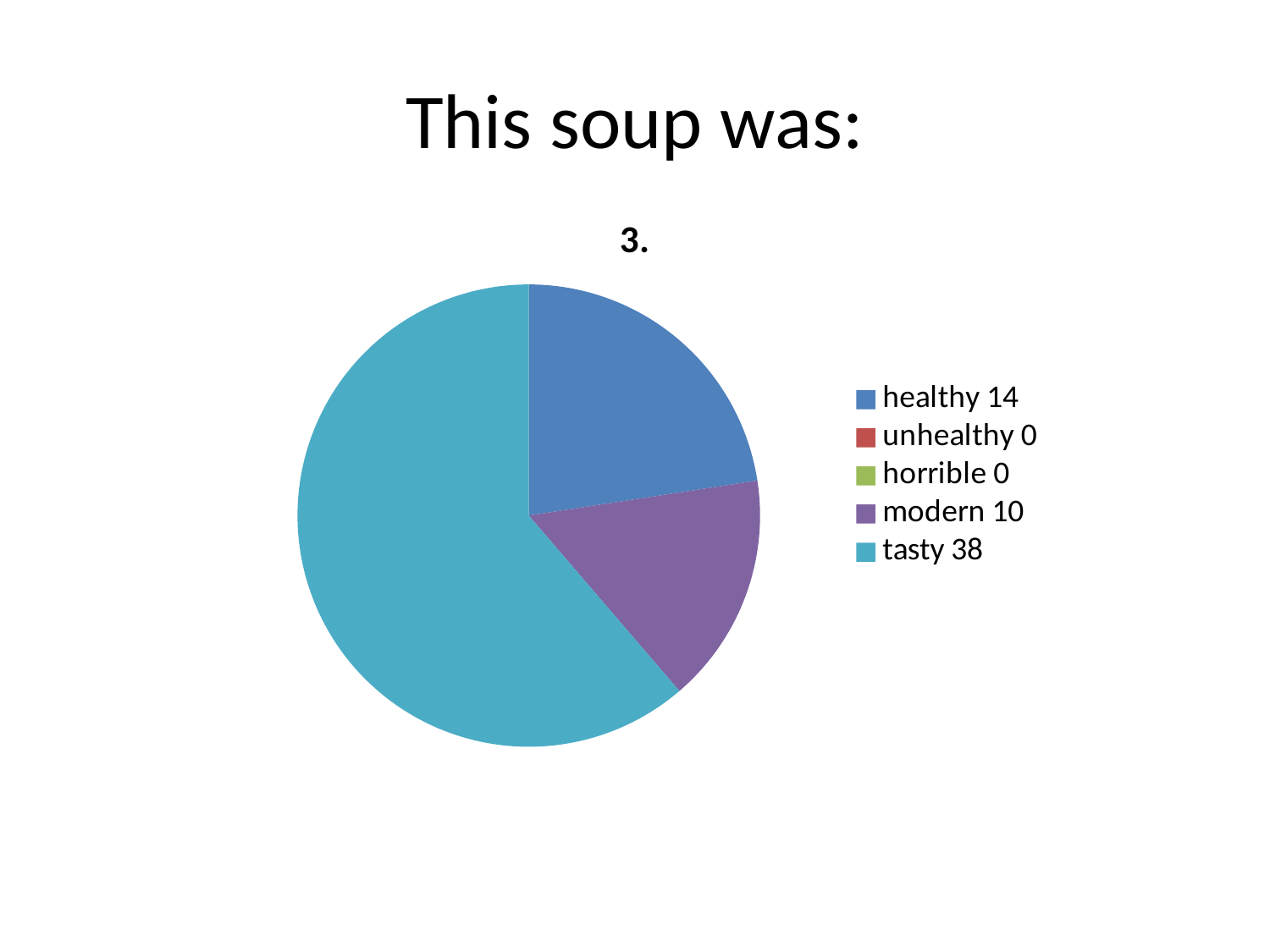
What is the total of all the values shown in the pie chart's legend? 62 What is the value for unhealthy in the pie chart? 0 How many categories does the legend of the pie chart list? 5 What is the value for healthy in the pie chart? 14 Which category has the largest slice of the pie chart? tasty What is the value for modern in the pie chart? 10 What type of chart is shown on the slide? pie chart What is the difference between the values for tasty and healthy? 24 What is the value for tasty in the pie chart? 38 What is the title shown above the pie chart? 3. Which is larger, the value for healthy or the value for modern? healthy Which category has the smallest non-zero value in the pie chart? modern